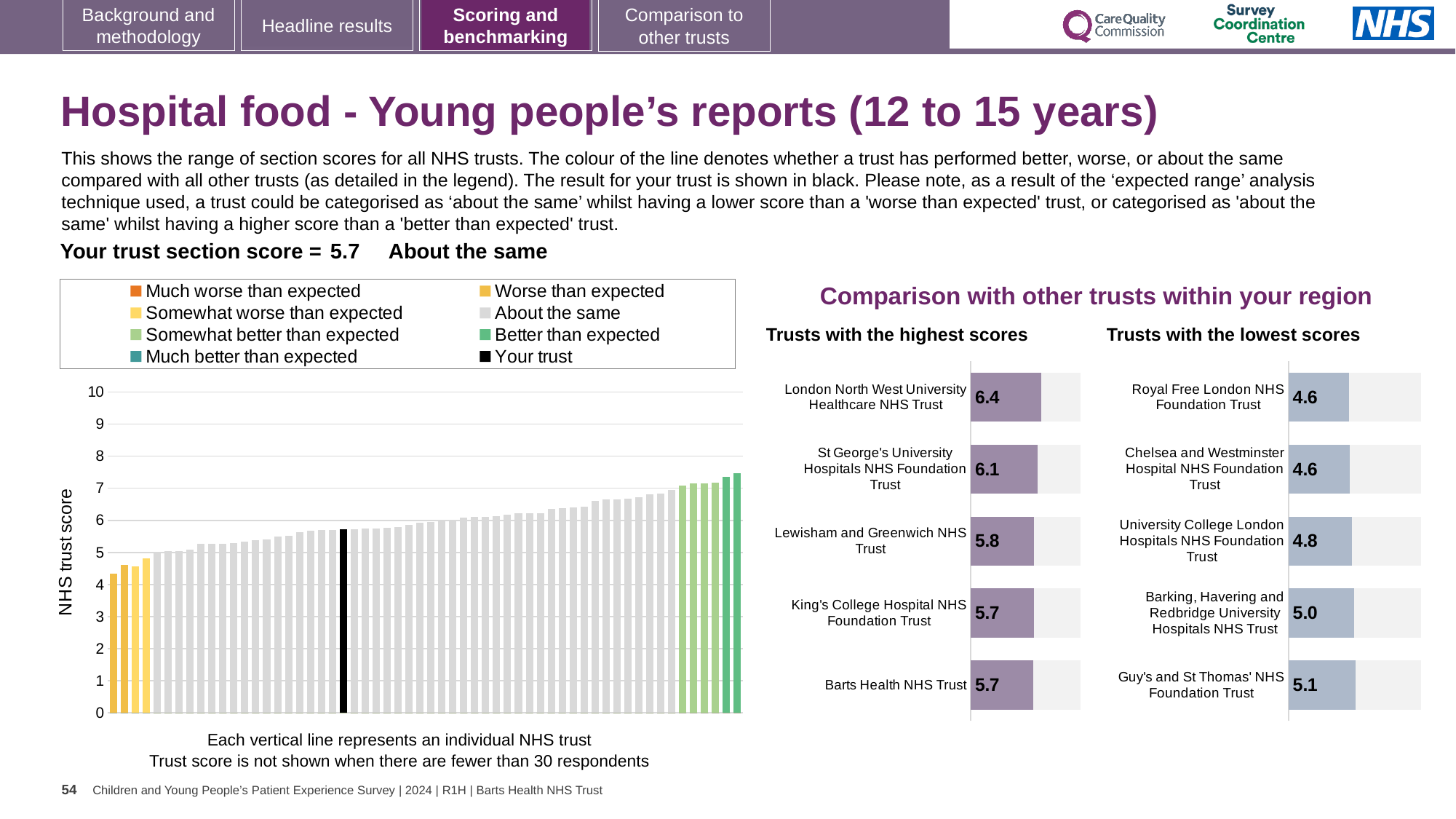
In the 'Trusts with the highest scores' chart, what is the score for Lewisham and Greenwich NHS Trust? 5.8 In the NHS trust score chart on the left, do the bar values rise or fall from left to right? rise In the NHS trust score chart on the left, is the value for the black 'Your trust' bar greater or less than 5? greater In the 'Trusts with the lowest scores' chart, what is the score for University College London Hospitals NHS Foundation Trust? 4.8 How many trusts are shown in the 'Trusts with the lowest scores' chart? 5 In the 'Trusts with the lowest scores' chart, what is the difference between the scores of Guy's and St Thomas' NHS Foundation Trust and Royal Free London NHS Foundation Trust? 0.5 In the 'Trusts with the highest scores' chart, which trust has the highest score? London North West University Healthcare NHS Trust In the 'Trusts with the lowest scores' chart, which trust has the highest score? Guy's and St Thomas' NHS Foundation Trust How many entries does the legend of the NHS trust score chart on the left list? 8 In the 'Trusts with the highest scores' chart, what is the score for London North West University Healthcare NHS Trust? 6.4 In the 'Trusts with the highest scores' chart, what is the difference between the scores of London North West University Healthcare NHS Trust and Lewisham and Greenwich NHS Trust? 0.6 In the 'Trusts with the highest scores' chart, which has the larger score: St George's University Hospitals NHS Foundation Trust or King's College Hospital NHS Foundation Trust? St George's University Hospitals NHS Foundation Trust